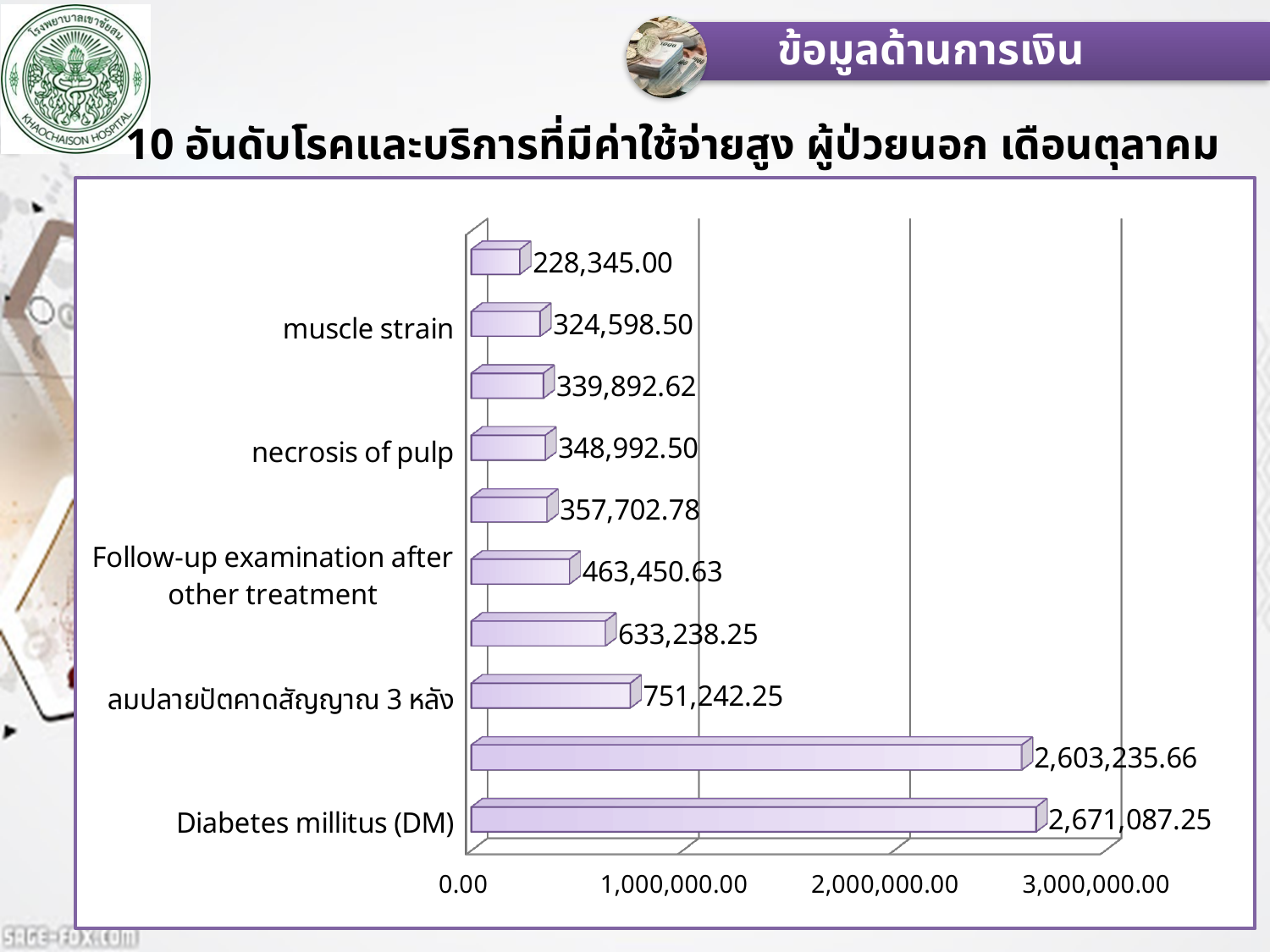
What is the value for necrosis of pulp? 348,992.50 Which category has the highest value? Diabetes millitus (DM) What is the difference between the values for Diabetes millitus (DM) and ลมปลายปัตคาดสัญญาณ 3 หลัง? 1,919,845.00 What is the value for Follow-up examination after other treatment? 463,450.63 What is the value for muscle strain? 324,598.50 What kind of chart is shown on the slide? bar chart How many bars are plotted in the chart? 10 What is the value for ลมปลายปัตคาดสัญญาณ 3 หลัง? 751,242.25 What is the value for Diabetes millitus (DM)? 2,671,087.25 Is the value for Diabetes millitus (DM) greater or less than 2,000,000.00? greater What is the difference between the values for necrosis of pulp and muscle strain? 24,394.00 Which is larger, the value for Follow-up examination after other treatment or the value for necrosis of pulp? Follow-up examination after other treatment